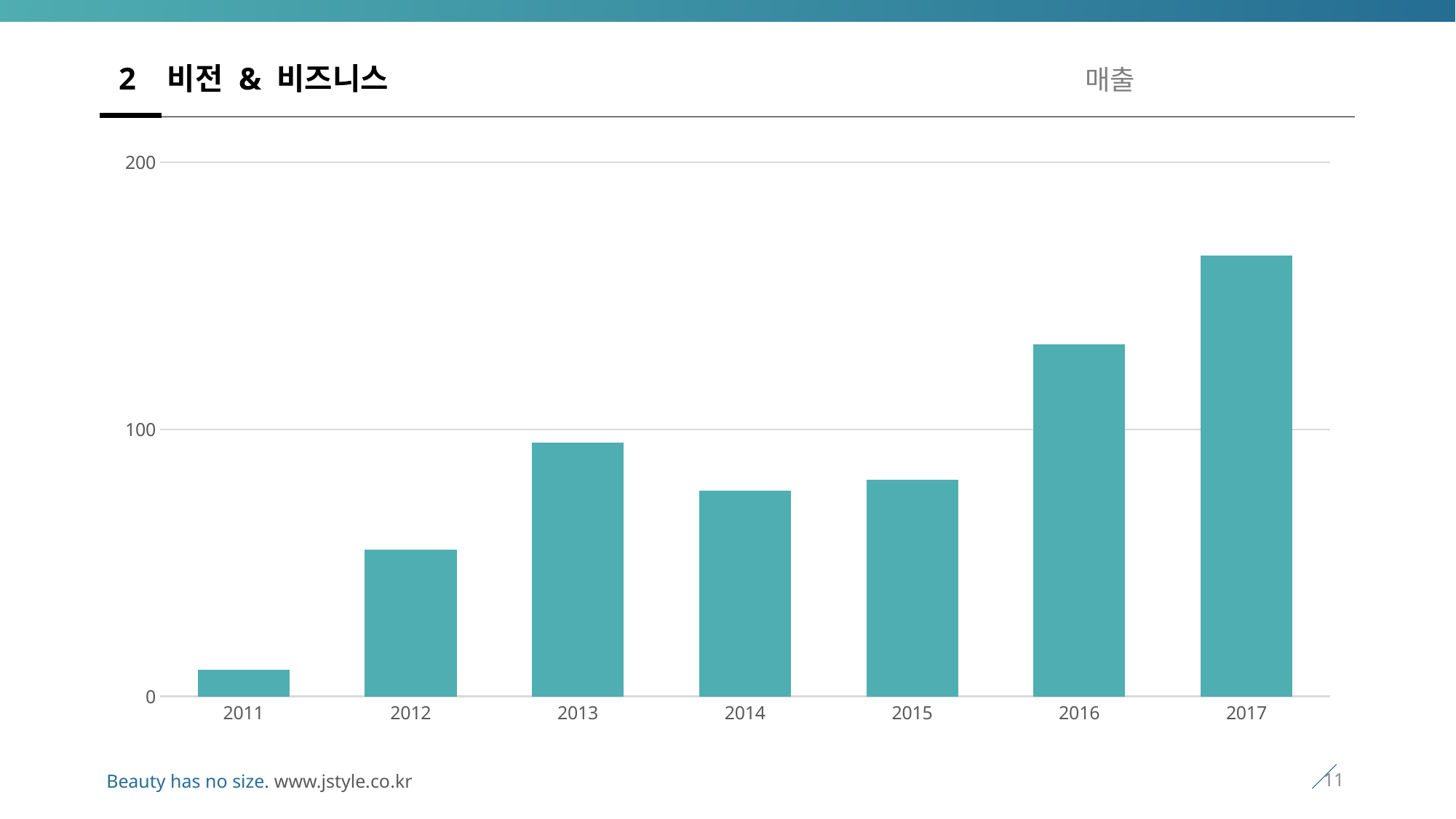
Is the value for 2017 higher or lower than the value for 2011? higher How many years are shown on the x axis of the chart? 7 Is the value for 2012 greater or less than 100? less What kind of chart is shown on the slide? bar chart Which is larger, the value for 2012 or the value for 2014? 2014 Which is larger, the value for 2013 or the value for 2016? 2016 Is the value for 2017 greater or less than 200? less Is the value for 2014 greater or less than 100? less What is the title of the chart? 매출 Which year has the highest value in the chart? 2017 Which year has the lowest value in the chart? 2011